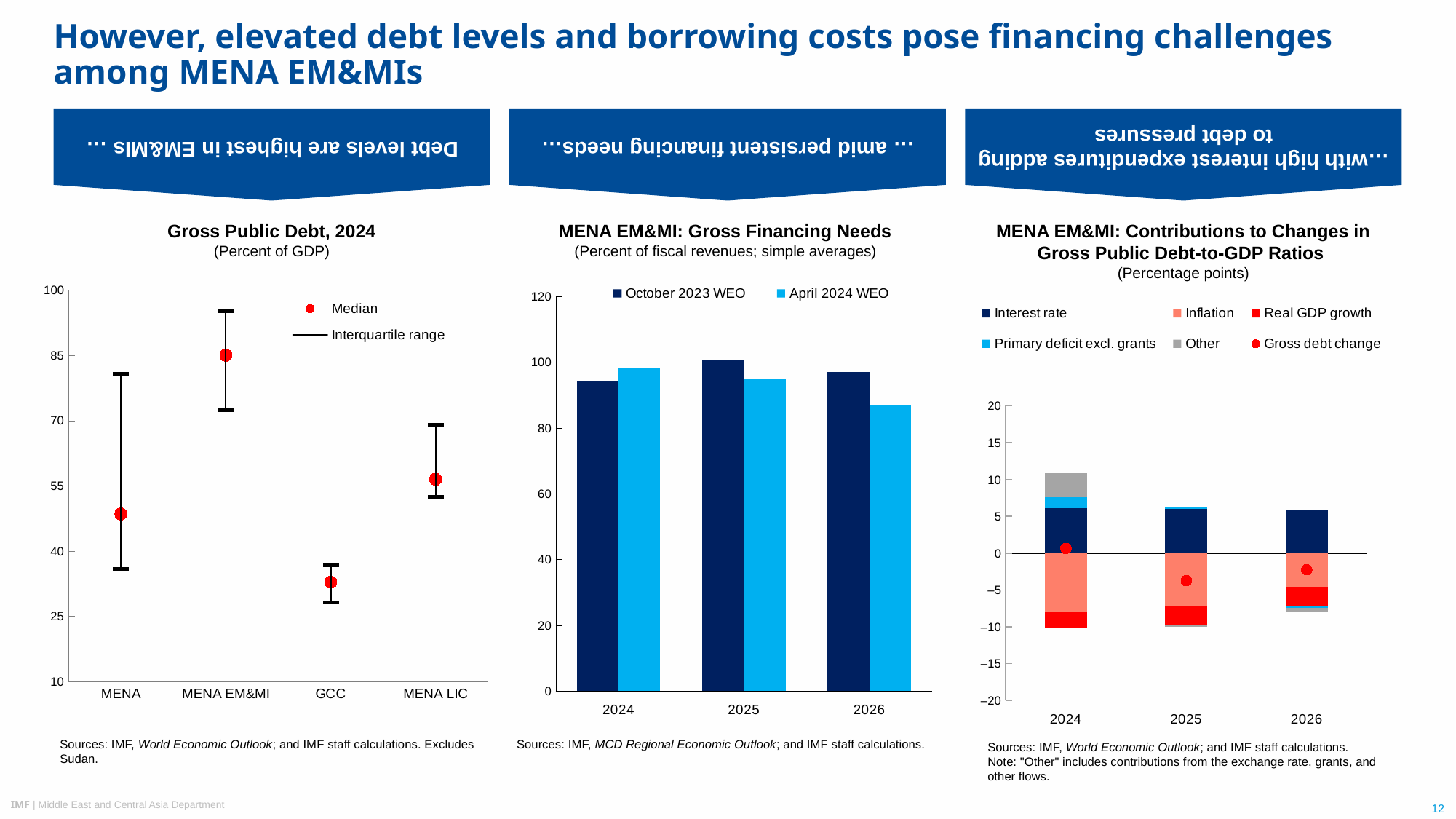
In the left chart, 'Gross Public Debt, 2024', which group has the lowest median? GCC What kind of chart is the middle chart, 'MENA EM&MI: Gross Financing Needs'? Bar chart In the left chart, 'Gross Public Debt, 2024', which group has the highest median? MENA EM&MI In the right chart, 'MENA EM&MI: Contributions to Changes in Gross Public Debt-to-GDP Ratios', how many entries does the legend list? 6 In the middle chart, 'MENA EM&MI: Gross Financing Needs', do the April 2024 WEO values rise or fall from 2024 to 2026? fall In the left chart, 'Gross Public Debt, 2024', is the median for GCC greater or less than 40? less In the left chart, 'Gross Public Debt, 2024', how many country groups are shown on the x axis? 4 In the middle chart, 'MENA EM&MI: Gross Financing Needs', how many series does the legend list? 2 In the middle chart, 'MENA EM&MI: Gross Financing Needs', for 2026, which is larger: the October 2023 WEO value or the April 2024 WEO value? October 2023 WEO In the right chart, 'MENA EM&MI: Contributions to Changes in Gross Public Debt-to-GDP Ratios', is the Gross debt change for 2025 greater or less than 0? less In the middle chart, 'MENA EM&MI: Gross Financing Needs', is the April 2024 WEO value for 2026 greater or less than 100? less In the left chart, 'Gross Public Debt, 2024', what two items does the legend list? Median and Interquartile range